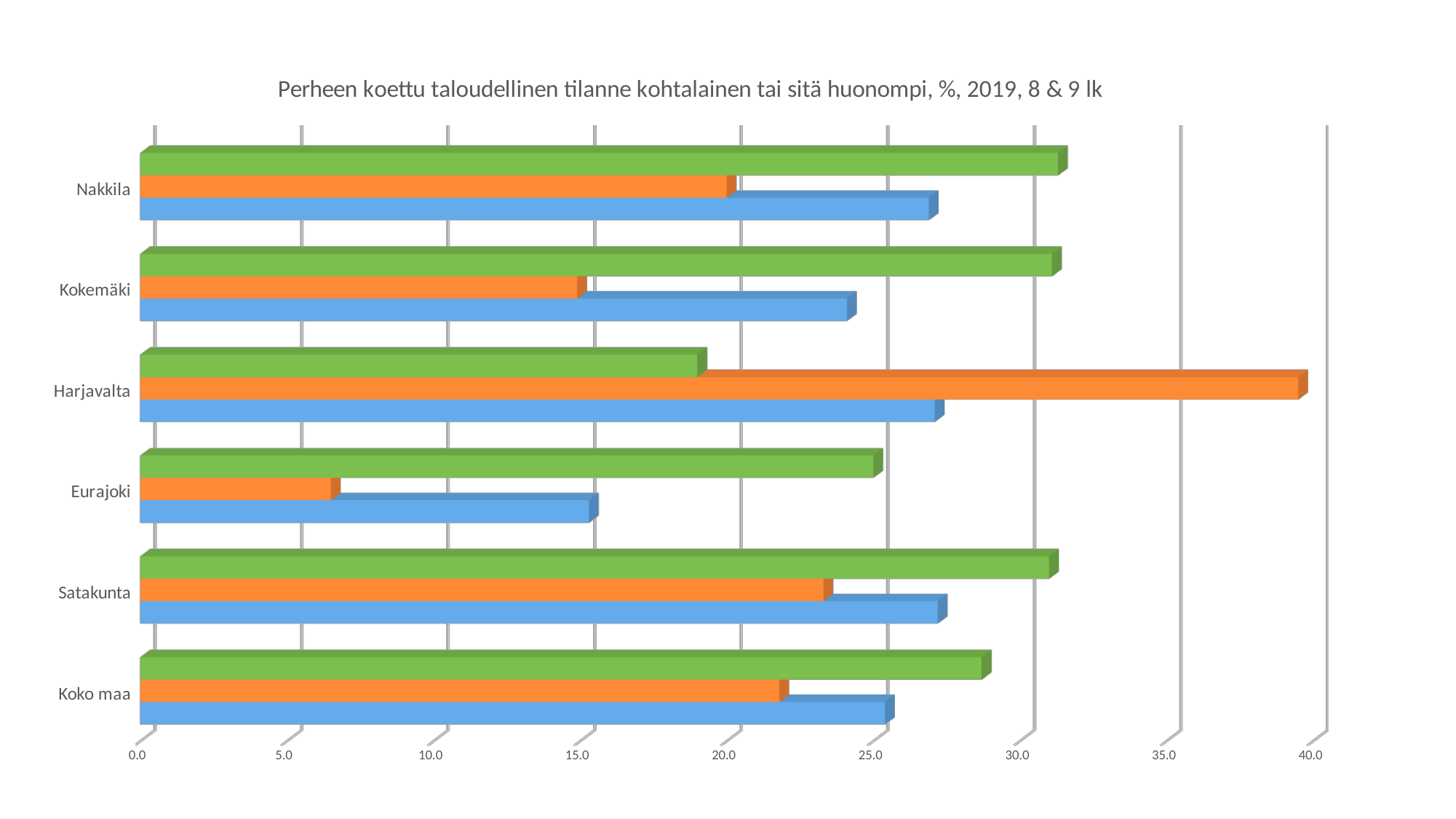
For Eurajoki, which is larger, the green bar or the blue bar? the green bar Which category has the longest orange bar? Harjavalta Is the orange bar for Harjavalta greater or less than 35.0? greater Which category has the shortest blue bar? Eurajoki What kind of chart is shown on the slide? bar chart Which category has the shortest orange bar? Eurajoki Which category has the shortest green bar? Harjavalta How many categories are shown on the vertical axis of the chart? 6 Is the green bar for Nakkila greater or less than 30.0? greater Is the blue bar for Eurajoki greater or less than 20.0? less What is the title of the chart? Perheen koettu taloudellinen tilanne kohtalainen tai sitä huonompi, %, 2019, 8 & 9 lk For Harjavalta, which is larger, the orange bar or the green bar? the orange bar